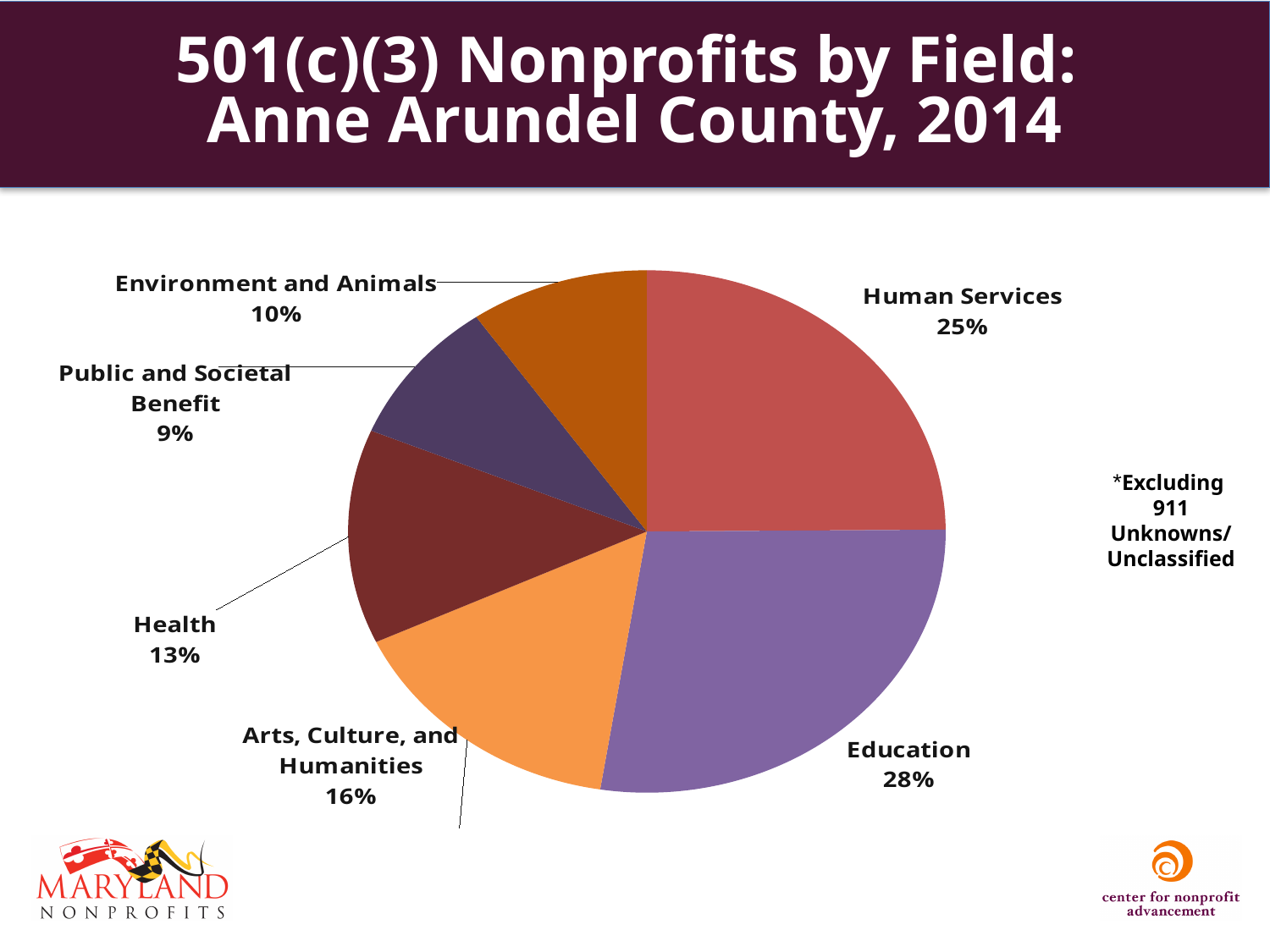
Which field has the smallest share of nonprofits? Public and Societal Benefit Which is larger, Health or Environment and Animals? Health What share of 501(c)(3) nonprofits in Anne Arundel County is in Education? 28% What share is Public and Societal Benefit? 9% What percentage of the pie is Human Services? 25% What share does Arts, Culture, and Humanities hold? 16% How many percentage points larger is Education than Human Services? 3 How many fields (slices) are shown in the pie chart? 6 What is the title of the chart? 501(c)(3) Nonprofits by Field: Anne Arundel County, 2014 What is the percentage for Health? 13% Which field has the largest share of nonprofits? Education What type of chart is shown on the slide? Pie chart